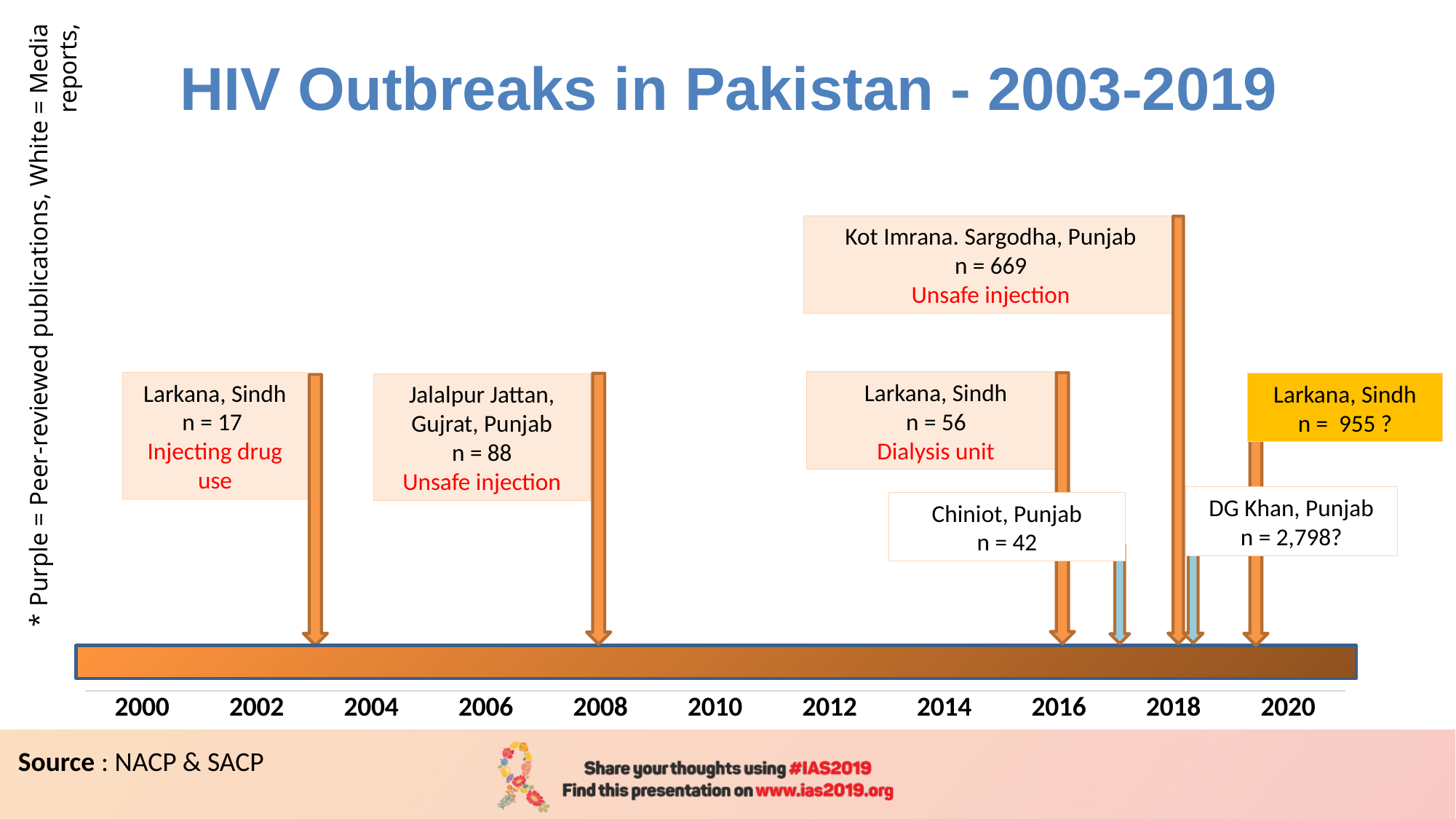
What is the value of n for the Larkana, Sindh outbreak linked to a dialysis unit? 56 What is the value of n for the Chiniot, Punjab outbreak? 42 Which outbreak on the timeline has the largest n value? DG Khan, Punjab What is the value of n for the Jalalpur Jattan, Gujrat, Punjab outbreak? 88 How many outbreaks are labelled on the timeline? 7 Which has a larger n value, the Kot Imrana, Sargodha outbreak or the Chiniot, Punjab outbreak? Kot Imrana, Sargodha What kind of chart is shown on the slide? timeline What is the difference in n between the Kot Imrana, Sargodha outbreak and the Jalalpur Jattan, Gujrat outbreak? 581 What is the value of n for the Kot Imrana, Sargodha, Punjab outbreak? 669 What is the title of the chart on the slide? HIV Outbreaks in Pakistan - 2003-2019 Which outbreak on the timeline has the smallest n value? Larkana, Sindh (n = 17, injecting drug use) What is the value of n for the DG Khan, Punjab outbreak? 2,798?